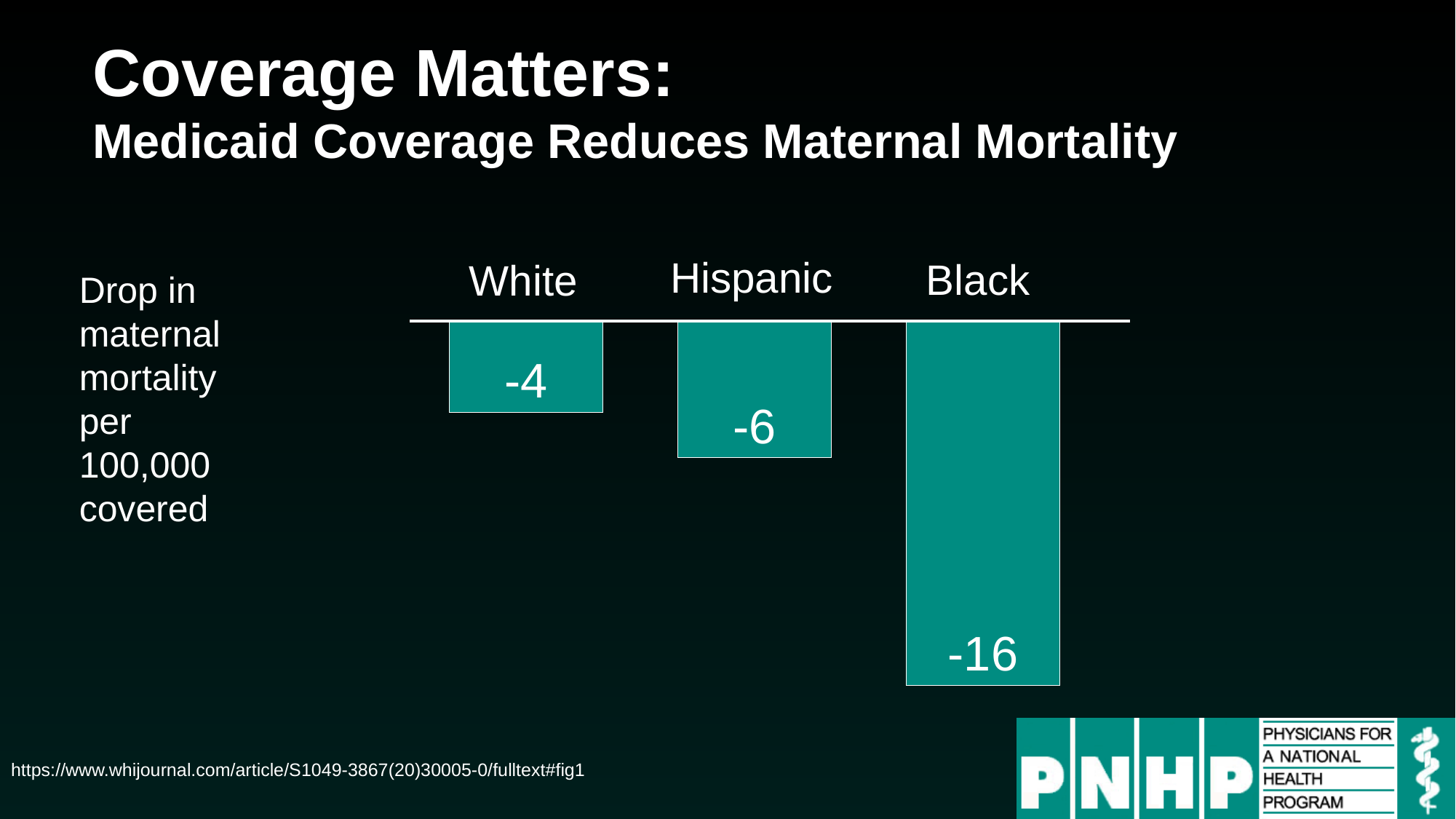
Which category shows the smallest drop in maternal mortality? White What is the value for Black in the chart? -16 What colour are the bars in the chart? Teal Which category shows the largest drop in maternal mortality? Black What is the value for White in the chart? -4 How many categories are shown in the chart? 3 What is the value for Hispanic in the chart? -6 Which has a larger drop in maternal mortality, Hispanic or White? Hispanic What is the difference between the values for Hispanic and White? 2 What kind of chart is shown on the slide? Bar chart What does the chart measure, according to the label on the left? Drop in maternal mortality per 100,000 covered What is the difference between the values for Black and White? 12